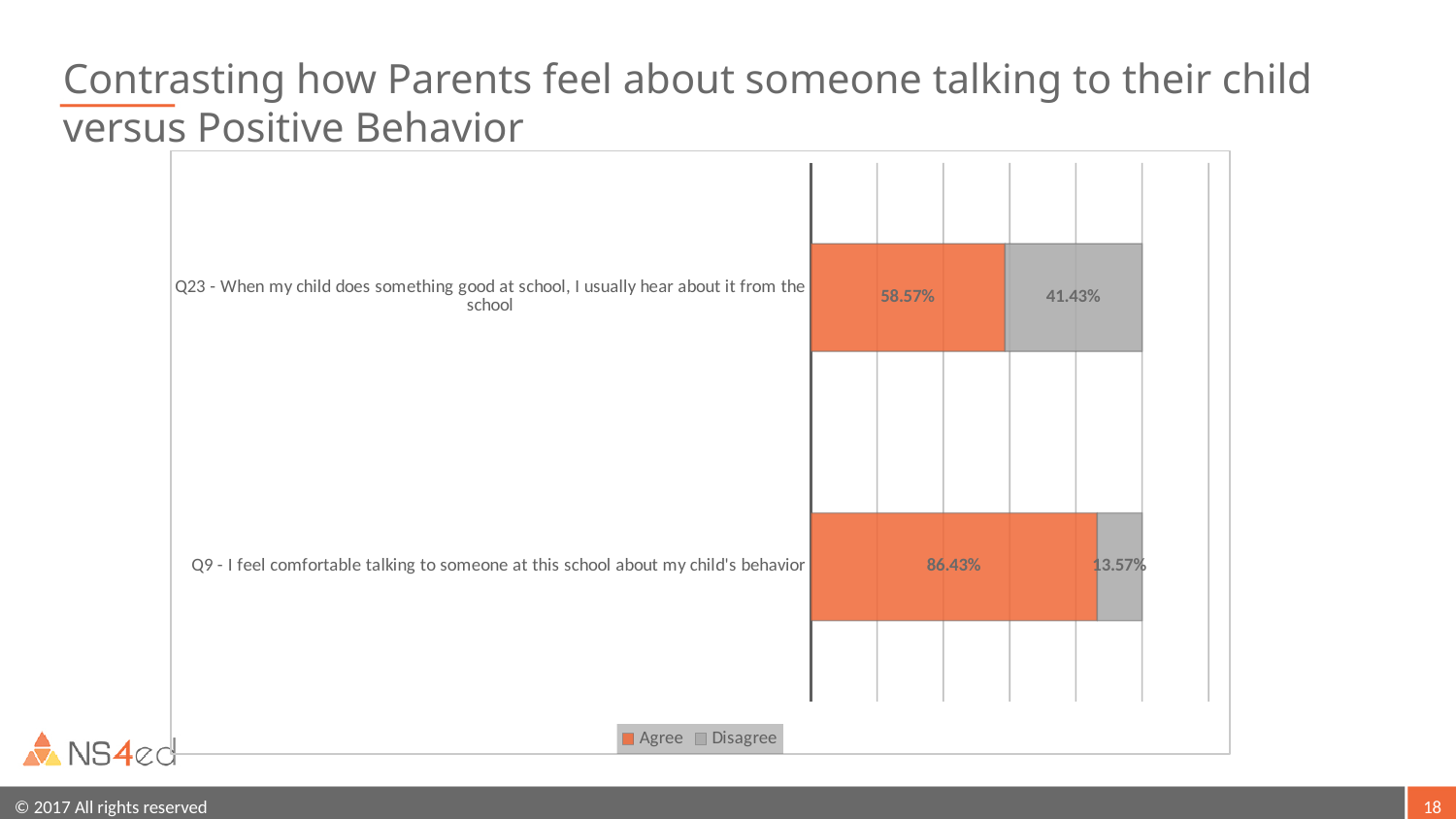
What is the Agree value for Q9 - I feel comfortable talking to someone at this school about my child's behavior? 86.43% What is the difference between the Agree and Disagree values for Q23? 17.14% What is the Disagree value for Q23 - When my child does something good at school, I usually hear about it from the school? 41.43% How many series does the legend list? 2 What is the total of the stacked bar for Q9? 100% How many categories (questions) are shown in the chart? 2 What is the Agree value for Q23 - When my child does something good at school, I usually hear about it from the school? 58.57% What is the difference between the Agree values for Q9 and Q23? 27.86% What kind of chart is shown on the slide? Stacked bar chart Which question has the lowest Disagree value? Q9 Which question has the higher Agree value, Q23 or Q9? Q9 What is the Disagree value for Q9 - I feel comfortable talking to someone at this school about my child's behavior? 13.57%